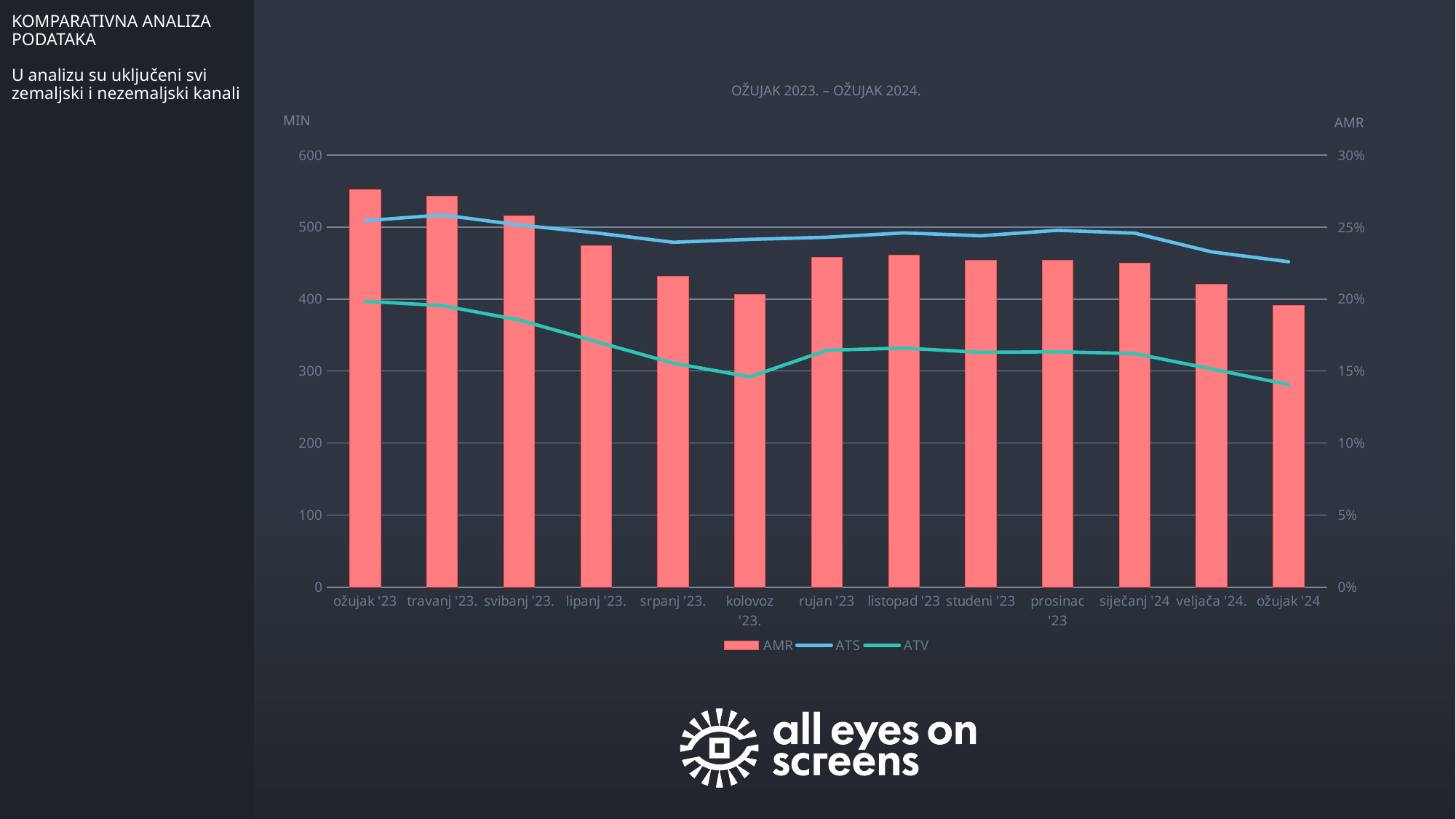
What is the title of the chart? OŽUJAK 2023. – OŽUJAK 2024. Which line is higher throughout the chart, ATS or ATV? ATS Does the ATV line rise or fall from ožujak '23 to kolovoz '23.? fall Which is larger, the AMR bar for kolovoz '23. or the AMR bar for rujan '23? rujan '23 What kind of chart is shown on the slide? Combined bar and line chart Which month has the lowest AMR bar? ožujak '24 Is the AMR bar for lipanj '23. greater or less than 500 on the left axis? less Which is larger, the AMR bar for lipanj '23. or the AMR bar for srpanj '23.? lipanj '23. Is the AMR bar for srpanj '23. greater or less than 400 on the left axis? greater How many months (categories) are shown on the x axis? 13 How many series does the chart legend list? 3 Which series is drawn as bars in the chart? AMR